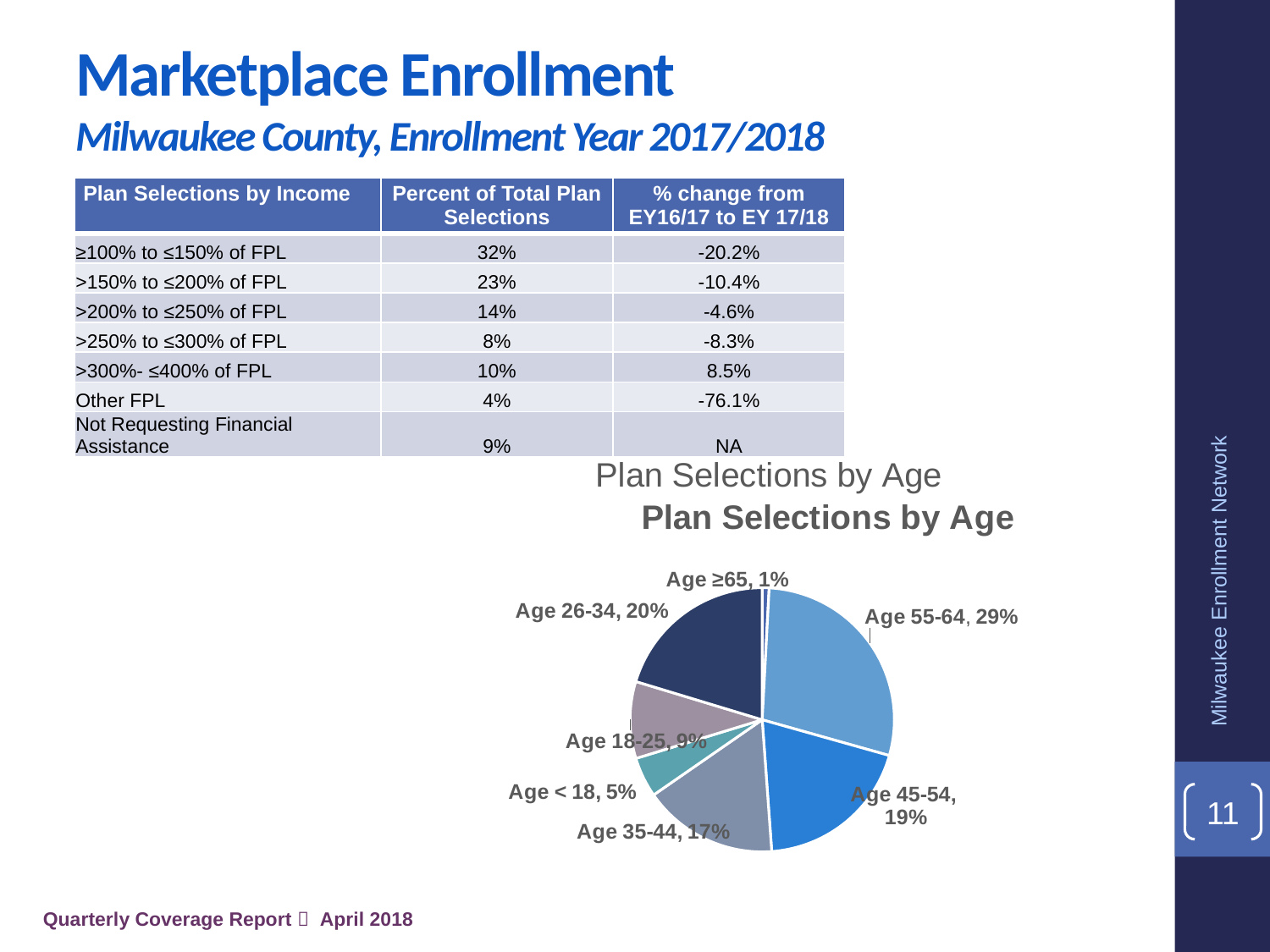
Which has a larger share of plan selections, Age 18-25 or Age 35-44? Age 35-44 Which age group has the smallest share of plan selections? Age ≥65 What is the title of the chart? Plan Selections by Age What share of plan selections is for Age 26-34? 20% What share of plan selections is for Age 35-44? 17% Which age group has the largest share of plan selections? Age 55-64 What is the difference in share between Age 55-64 and Age 45-54? 10% What share of plan selections is for Age < 18? 5% What share of plan selections is for Age 55-64? 29% What is the difference in share between Age 26-34 and Age < 18? 15% What kind of chart is shown on the slide? Pie chart How many age groups are shown in the pie chart? 7